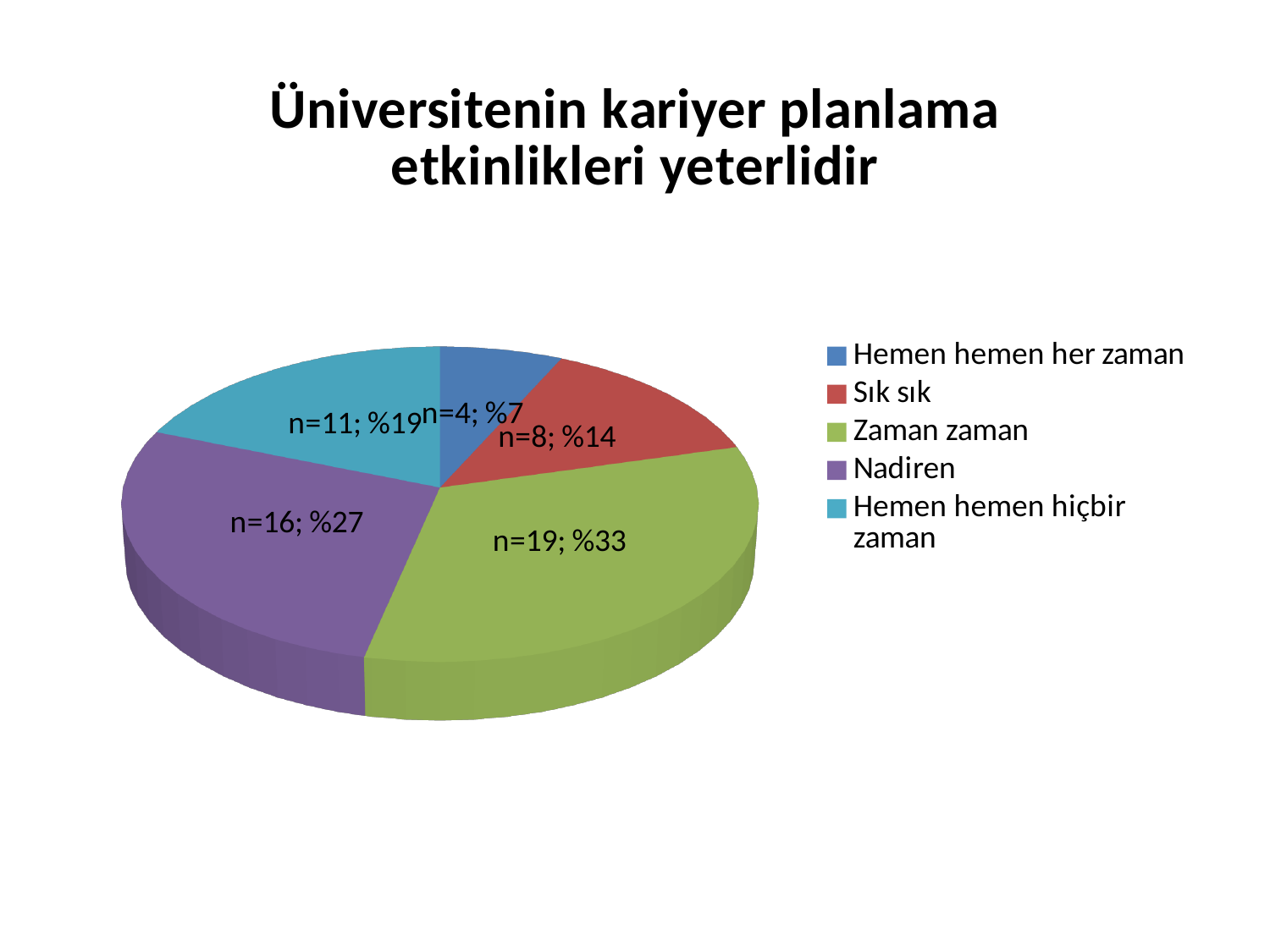
What kind of chart is shown on the slide? Pie chart Which colour represents 'Sık sık' in the legend? Red Which is larger, the 'Nadiren' slice or the 'Sık sık' slice? Nadiren What is the data label for 'Hemen hemen her zaman'? n=4; %7 What percentage share does 'Hemen hemen hiçbir zaman' have? %19 What is the difference in n between 'Zaman zaman' and 'Sık sık'? 11 What is the title of the chart? Üniversitenin kariyer planlama etkinlikleri yeterlidir How many slices does the pie chart have? 5 What is the n value for 'Nadiren'? 16 What is the data label for the 'Zaman zaman' slice? n=19; %33 Which category has the largest slice? Zaman zaman Which category has the smallest slice? Hemen hemen her zaman